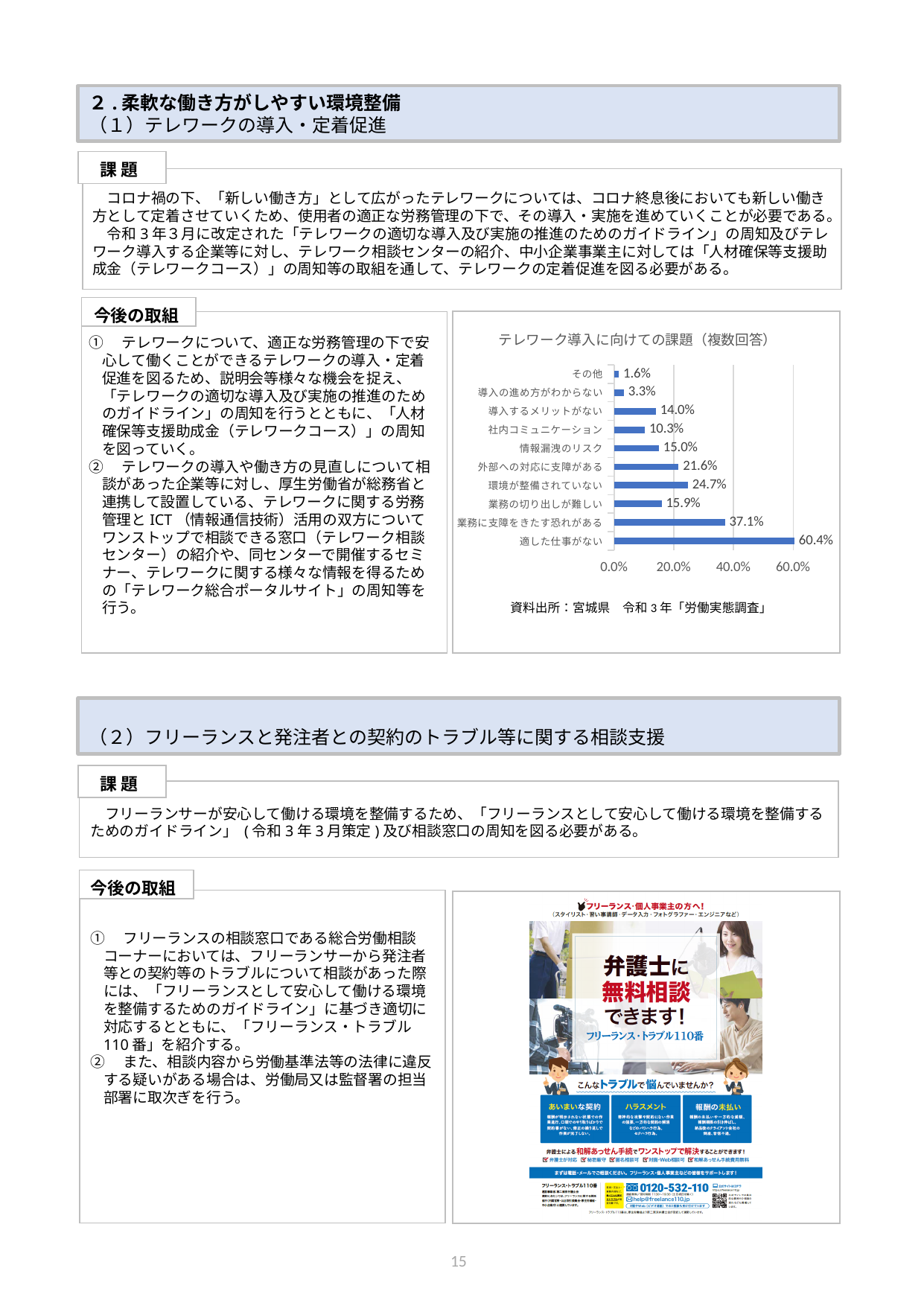
What is the value for 適した仕事がない? 60.4% Which category has the highest value? 適した仕事がない What is the title of the chart on the slide? テレワーク導入に向けての課題（複数回答） What type of chart is shown on the slide? bar chart Is the value for 業務に支障をきたす恐れがある greater or less than 40.0%? less What is the difference between the values for 適した仕事がない and 業務に支障をきたす恐れがある? 23.3% What is the source cited below the chart? 宮城県 令和3年「労働実態調査」 Which is larger, the value for 外部への対応に支障がある or the value for 業務の切り出しが難しい? 外部への対応に支障がある What is the value for 環境が整備されていない? 24.7% What is the value for 社内コミュニケーション? 10.3% Which category has the lowest value? その他 How many categories are plotted in the chart? 10